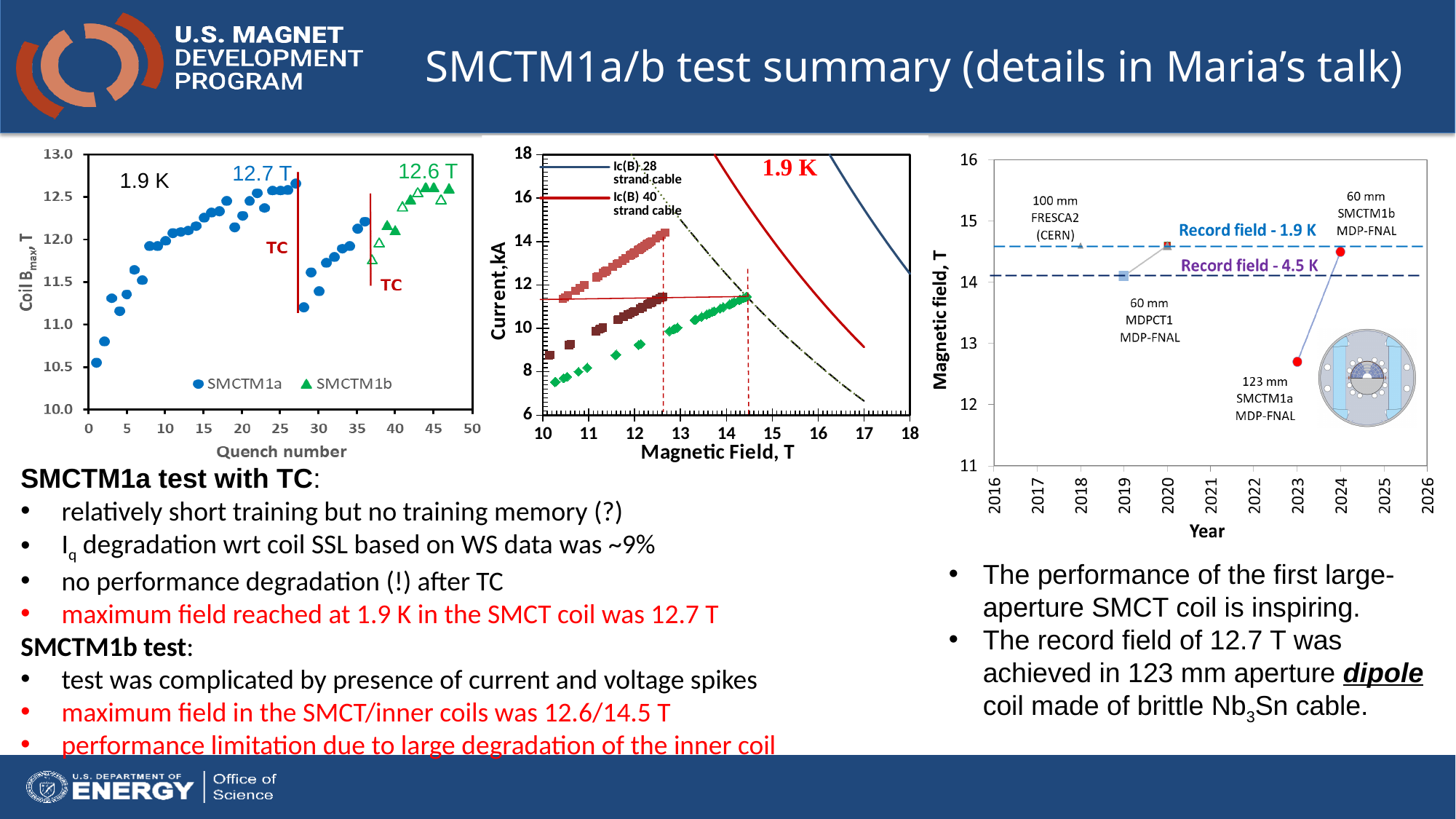
In the middle chart (Current vs Magnetic Field), what is the label of the y axis? Current, kA In the left chart (Coil Bmax vs Quench number), do the SMCTM1a values generally rise or fall as the quench number increases from 0 to 25? rise In the left chart (Coil Bmax vs Quench number), what maximum field is annotated for the SMCTM1a series? 12.7 T In the left chart (Coil Bmax vs Quench number), what temperature is annotated on the plot? 1.9 K In the middle chart (Current vs Magnetic Field), how many entries does the legend list? 2 In the left chart (Coil Bmax vs Quench number), how many series does the legend list? 2 In the left chart (Coil Bmax vs Quench number), what is the label of the x axis? Quench number In the right chart (Magnetic field vs Year), is the value for the 123 mm SMCTM1a MDP-FNAL point greater or less than 13? less In the right chart (Magnetic field vs Year), which is larger: the value for 123 mm SMCTM1a MDP-FNAL or the value for 100 mm FRESCA2 (CERN)? 100 mm FRESCA2 (CERN) In the right chart (Magnetic field vs Year), is the value for the 60 mm SMCTM1b MDP-FNAL point greater or less than 14? greater In the left chart (Coil Bmax vs Quench number), what maximum field is annotated for the SMCTM1b series? 12.6 T In the right chart (Magnetic field vs Year), which labelled point has the lowest magnetic field? 123 mm SMCTM1a MDP-FNAL